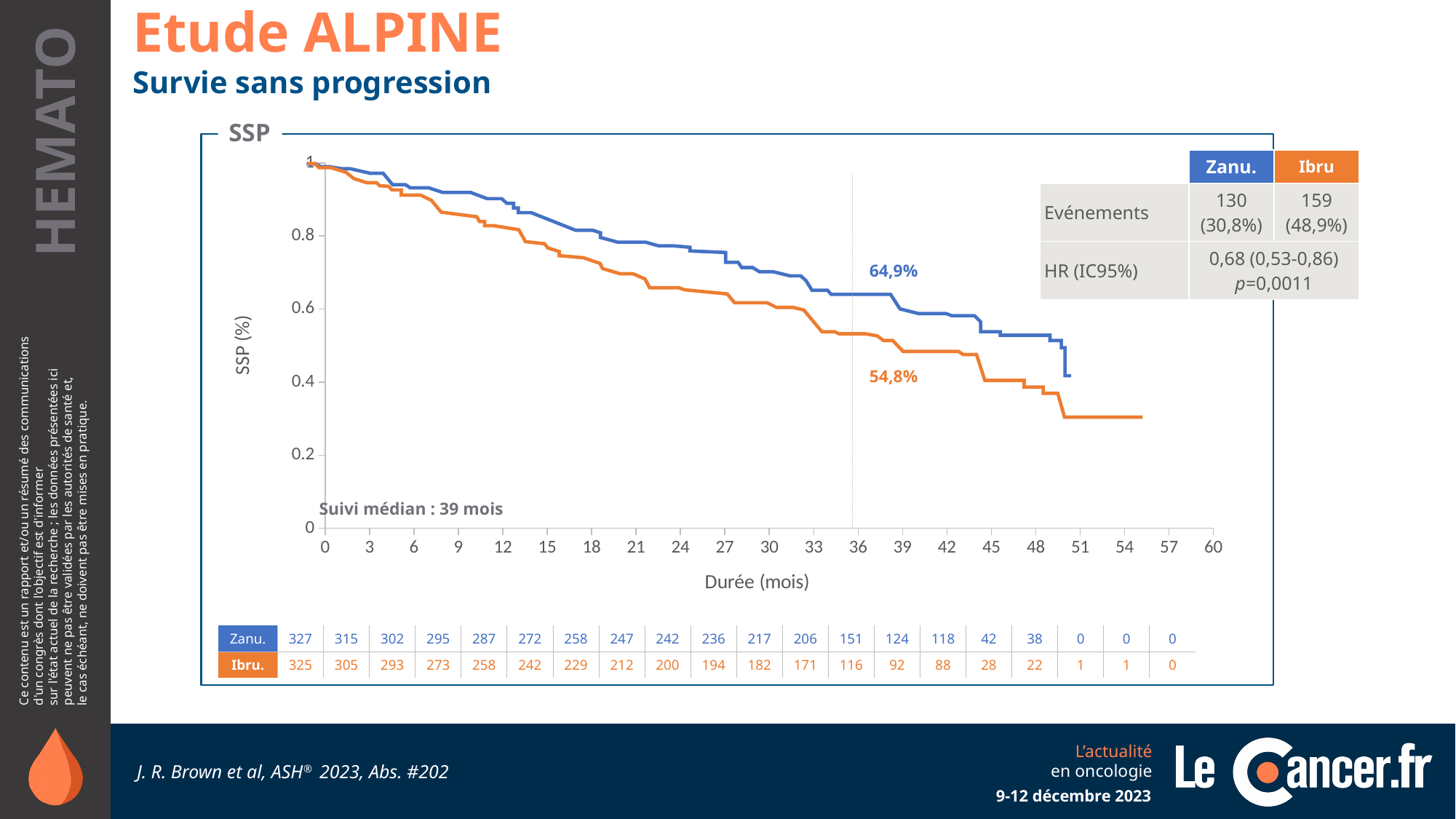
What is the median follow-up stated on the chart? 39 mois What is the labelled SSP value for the Zanu. curve at 36 months? 64,9% Which curve has the higher SSP at 36 months, Zanu. or Ibru? Zanu. Do the SSP curves rise or fall as duration increases? Fall How many events are reported for the Ibru arm? 159 (48,9%) What is the labelled SSP value for the Ibru curve at 36 months? 54,8% What is the difference between the labelled SSP values of Zanu. and Ibru at 36 months? 10,1% What is the label of the y axis of the chart? SSP (%) What type of chart is shown on the slide? Line chart How many events are reported for the Zanu. arm? 130 (30,8%) How many series are plotted on the SSP chart? 2 What is the hazard ratio (IC95%) shown on the chart? 0,68 (0,53-0,86)